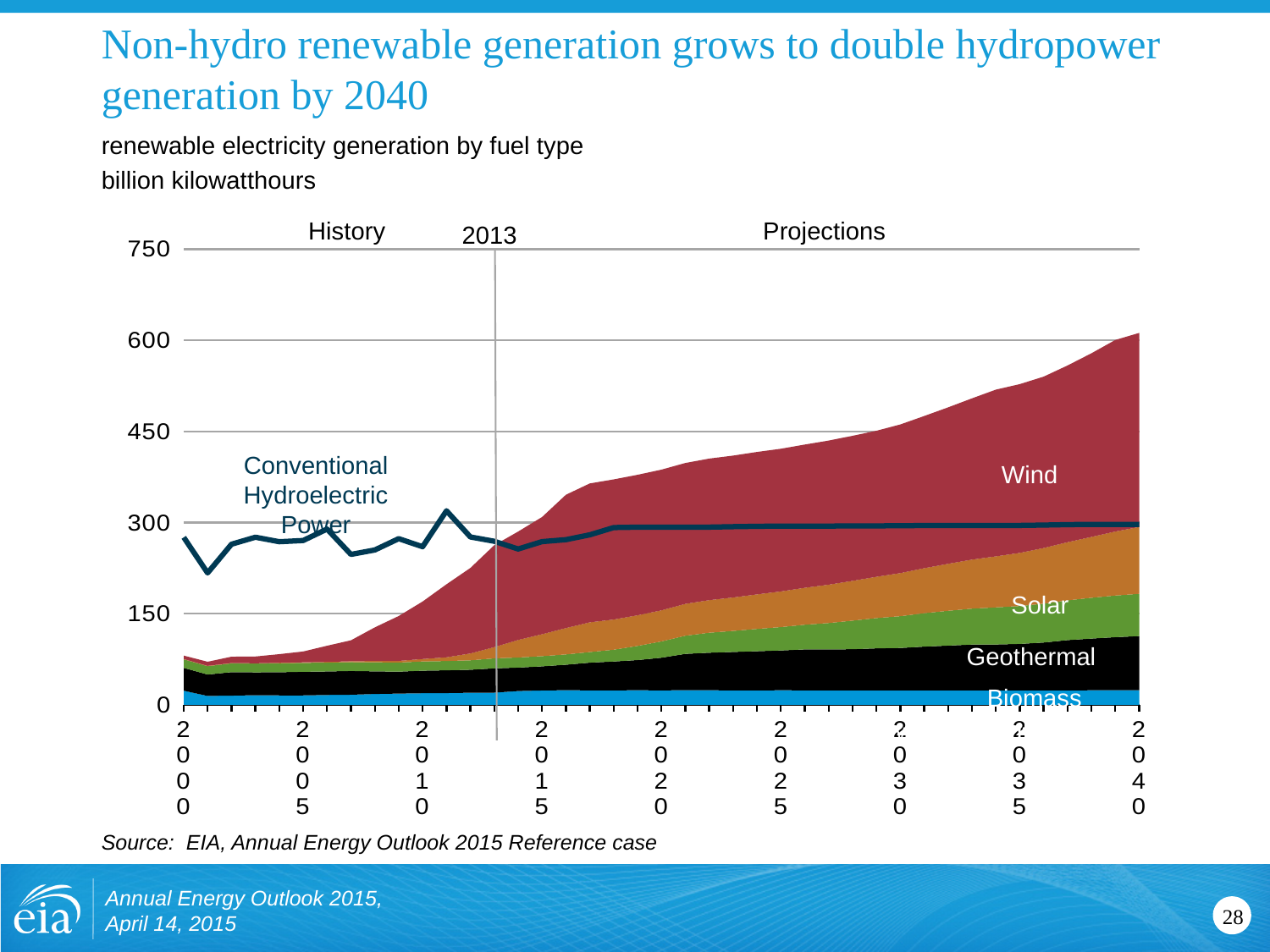
In 2040, which is larger: total non-hydro renewable generation or Conventional Hydroelectric Power? total non-hydro renewable generation In 2000, which is larger: Conventional Hydroelectric Power or total non-hydro renewable generation? Conventional Hydroelectric Power What kind of chart is shown on the slide? stacked area chart with a line Is the total non-hydro renewable generation in 2020 greater or less than 300? greater Which stacked series is the largest contributor to non-hydro renewable generation in 2040? Wind Is the Conventional Hydroelectric Power value in 2000 greater or less than 300? less Which series is shown as a line rather than a stacked area? Conventional Hydroelectric Power Is the total non-hydro renewable generation in 2040 greater or less than 450? greater What unit is the y axis measured in? billion kilowatthours How many fuel-type series are labeled on the chart? 5 Does the total non-hydro renewable generation rise or fall from 2013 to 2040? rise